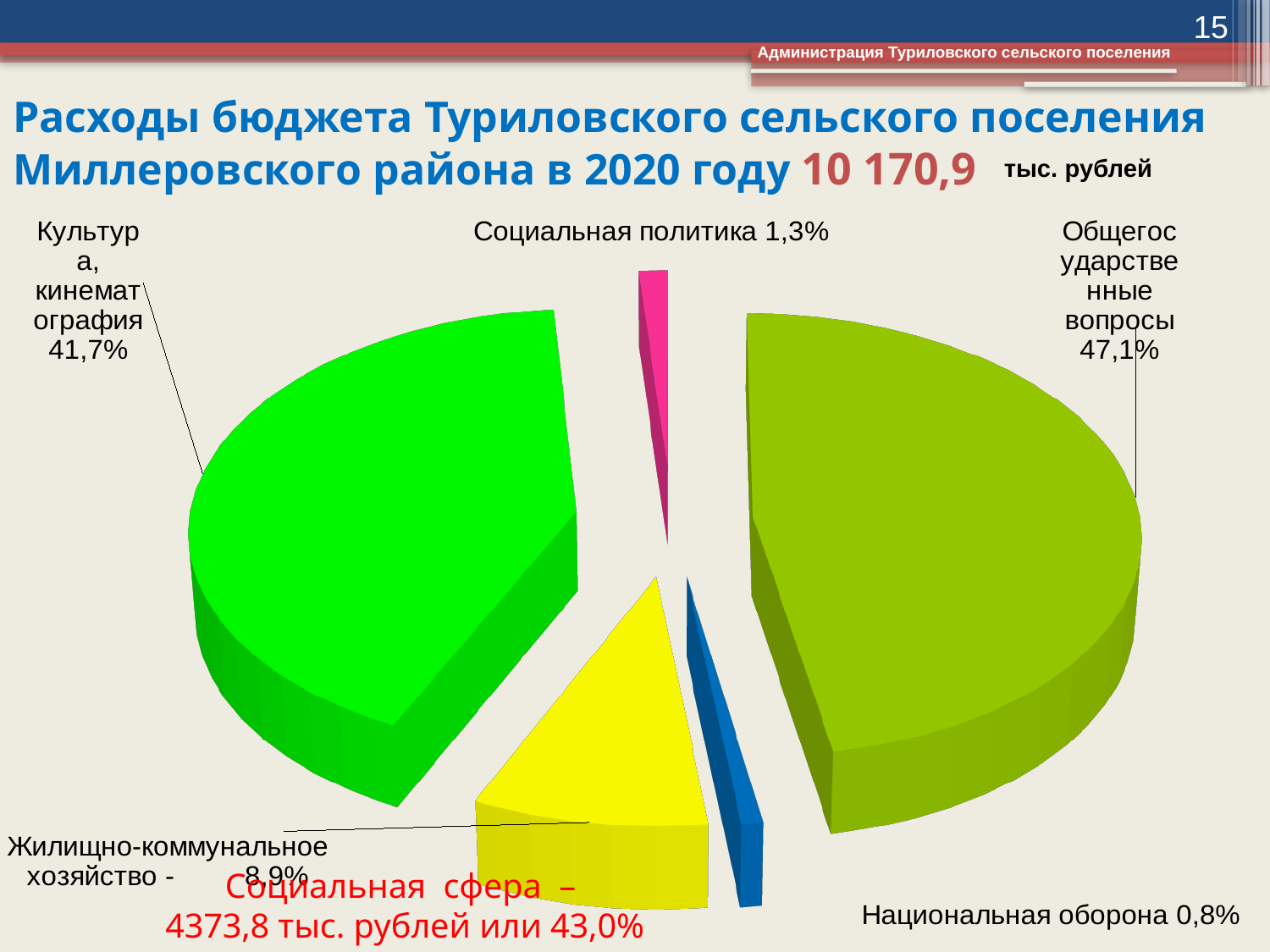
How many slices does the pie chart have? 5 What share of the budget expenditure goes to Жилищно-коммунальное хозяйство? 8,9% What total budget expenditure amount (in тыс. рублей) is stated in the slide title? 10 170,9 What share of the budget expenditure goes to Социальная политика? 1,3% What is the difference in percentage points between Общегосударственные вопросы and Культура, кинематография? 5,4 What kind of chart is shown on the slide? pie chart What share of the budget expenditure goes to Культура, кинематография? 41,7% What share of the budget expenditure goes to Национальная оборона? 0,8% What share of the budget expenditure goes to Общегосударственные вопросы? 47,1% Which category has the largest share of the pie? Общегосударственные вопросы Which is larger: the share for Социальная политика or the share for Национальная оборона? Социальная политика Which category has the smallest share of the pie? Национальная оборона